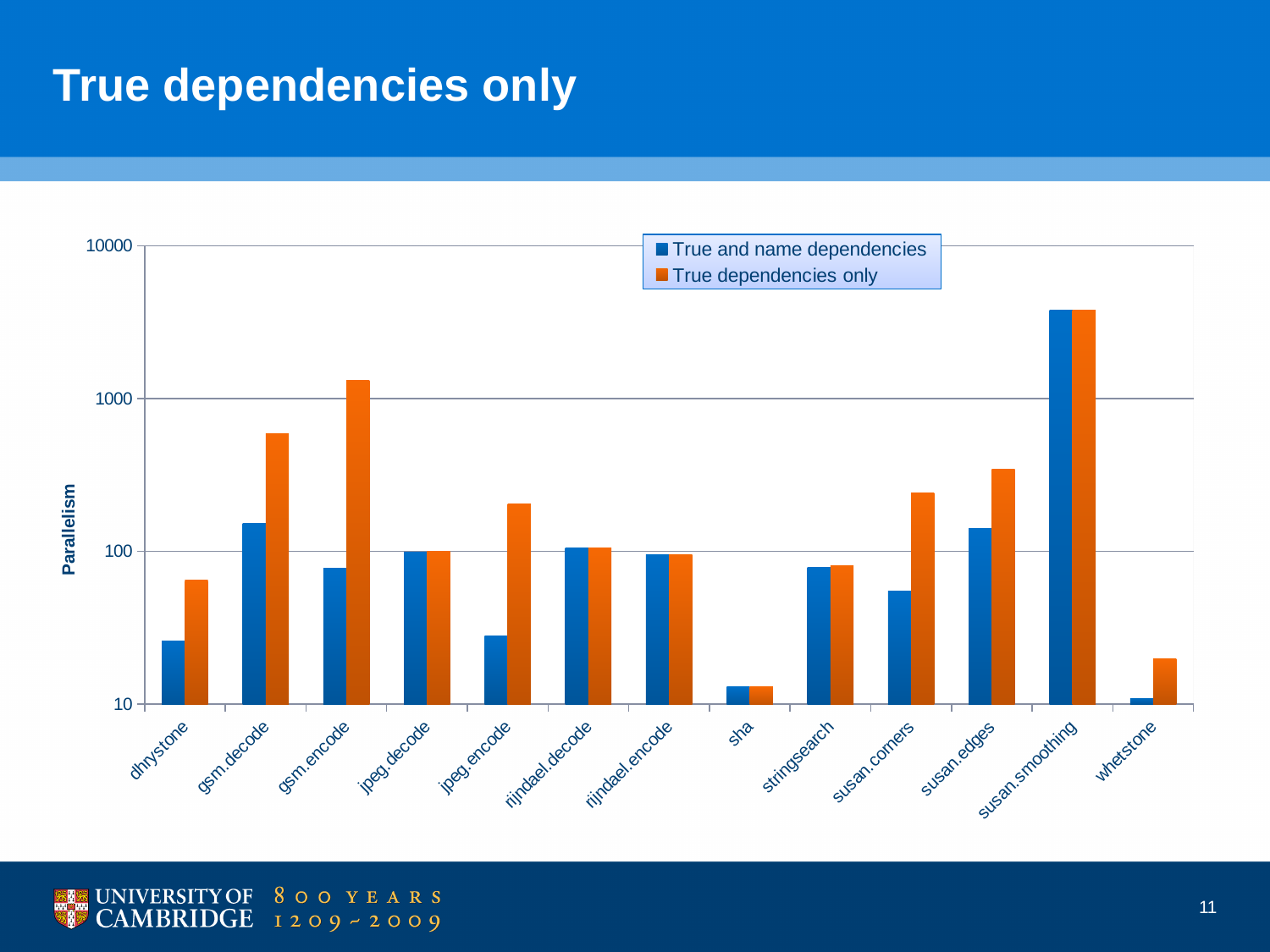
Is the 'True dependencies only' value for gsm.decode greater or less than 1000? less What is the label of the y axis? Parallelism How many benchmark categories are shown on the x axis? 13 Is the 'True dependencies only' value for gsm.encode greater or less than 1000? greater Is the 'True and name dependencies' value for dhrystone greater or less than 100? less Which benchmark has the lowest parallelism for the 'True dependencies only' series? sha Which benchmark has the highest parallelism for the 'True dependencies only' series? susan.smoothing How many series does the legend list? 2 What kind of chart is shown on the slide? bar chart For jpeg.encode, which series has the larger value: 'True and name dependencies' or 'True dependencies only'? True dependencies only Which colour represents the 'True dependencies only' series? orange